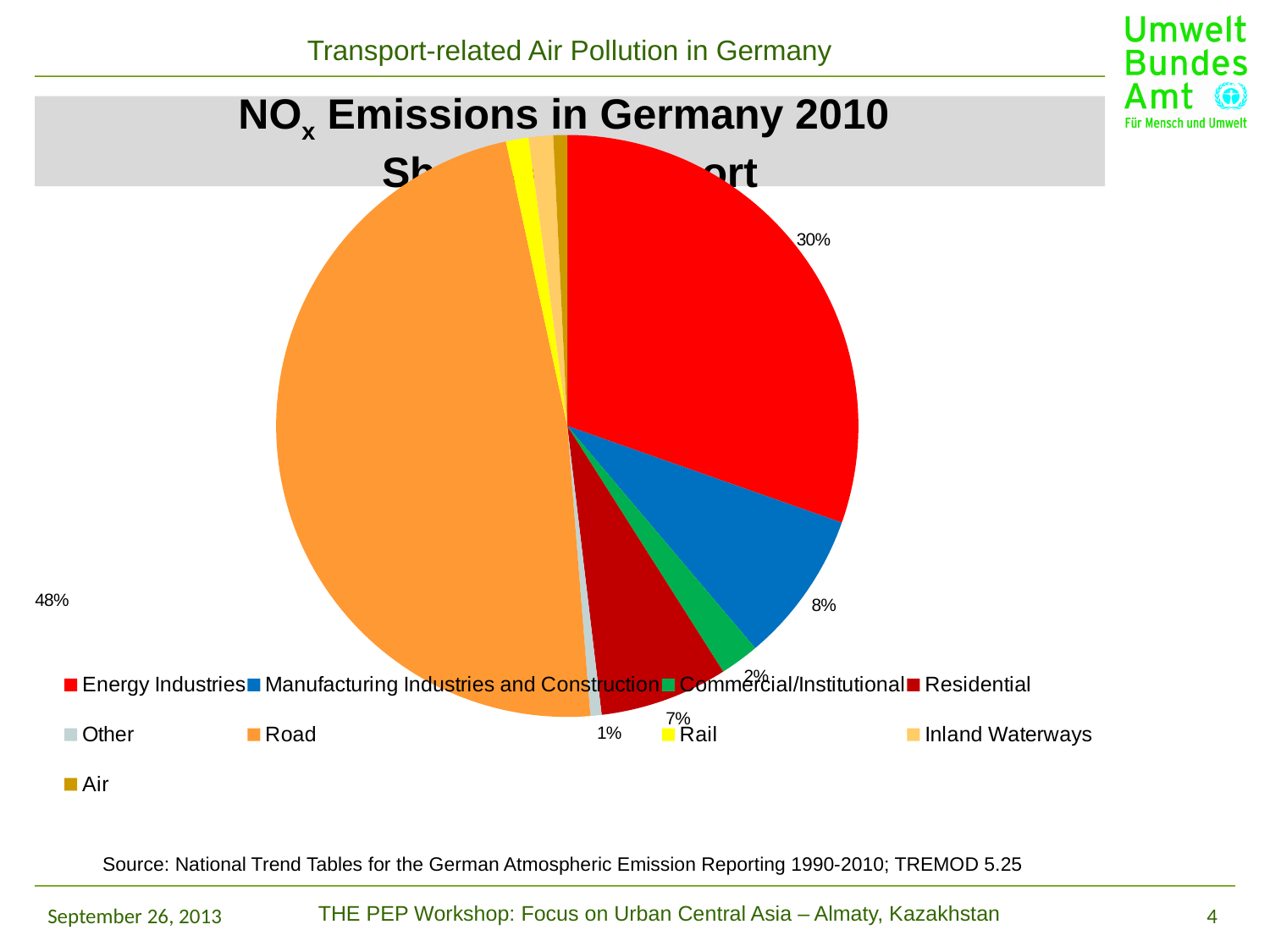
What colour represents Road in the pie chart? Orange What percentage does the Other category account for? 1% What percentage is shown for Manufacturing Industries and Construction? 8% What share of NOx emissions does Road account for in the pie chart? 48% Which has a larger share: Energy Industries or Manufacturing Industries and Construction? Energy Industries What share is shown for Commercial/Institutional? 2% What type of chart is shown on the slide? Pie chart Which category has the largest share of NOx emissions in the pie chart? Road What share is shown for Residential in the pie chart? 7% How many categories does the legend of the pie chart list? 9 What share of NOx emissions is attributed to Energy Industries? 30% By how many percentage points does the Road share exceed the Energy Industries share? 18 percentage points